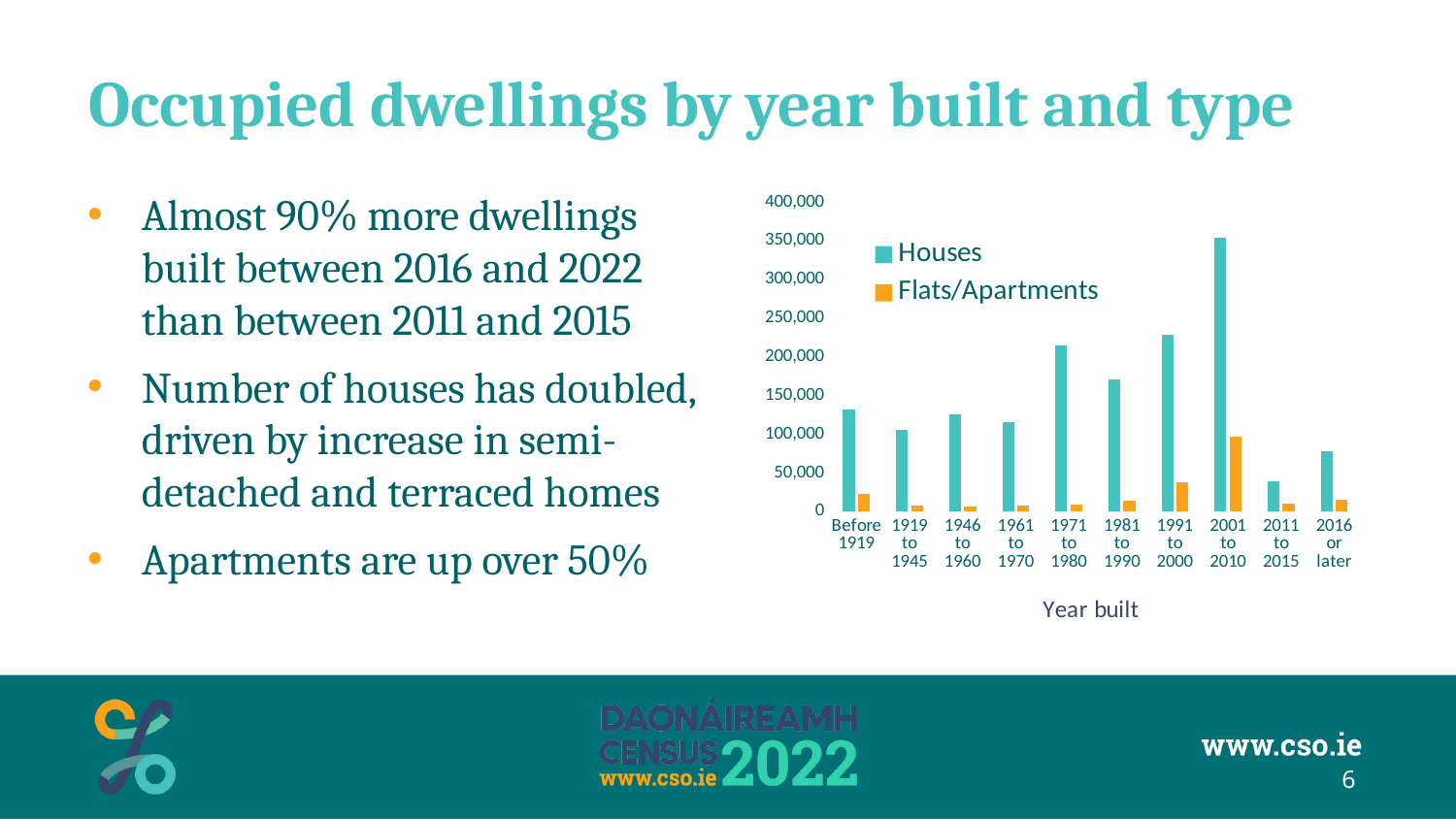
Which year-built category has the highest number of houses? 2001 to 2010 Is the number of houses built 2011 to 2015 greater or less than 50,000? less Which has more houses: 1981 to 1990 or 1991 to 2000? 1991 to 2000 Is the number of flats/apartments built 2001 to 2010 greater or less than 50,000? greater Which has more houses: 2011 to 2015 or 2016 or later? 2016 or later What is the title of the x axis of the chart? Year built How many series does the chart legend list? 2 Which year-built category has the highest number of flats/apartments? 2001 to 2010 What kind of chart is shown on the slide? Bar chart Which year-built category has the lowest number of houses? 2011 to 2015 How many year-built categories are shown on the x axis of the chart? 10 Is the number of houses built 2001 to 2010 greater or less than 300,000? greater